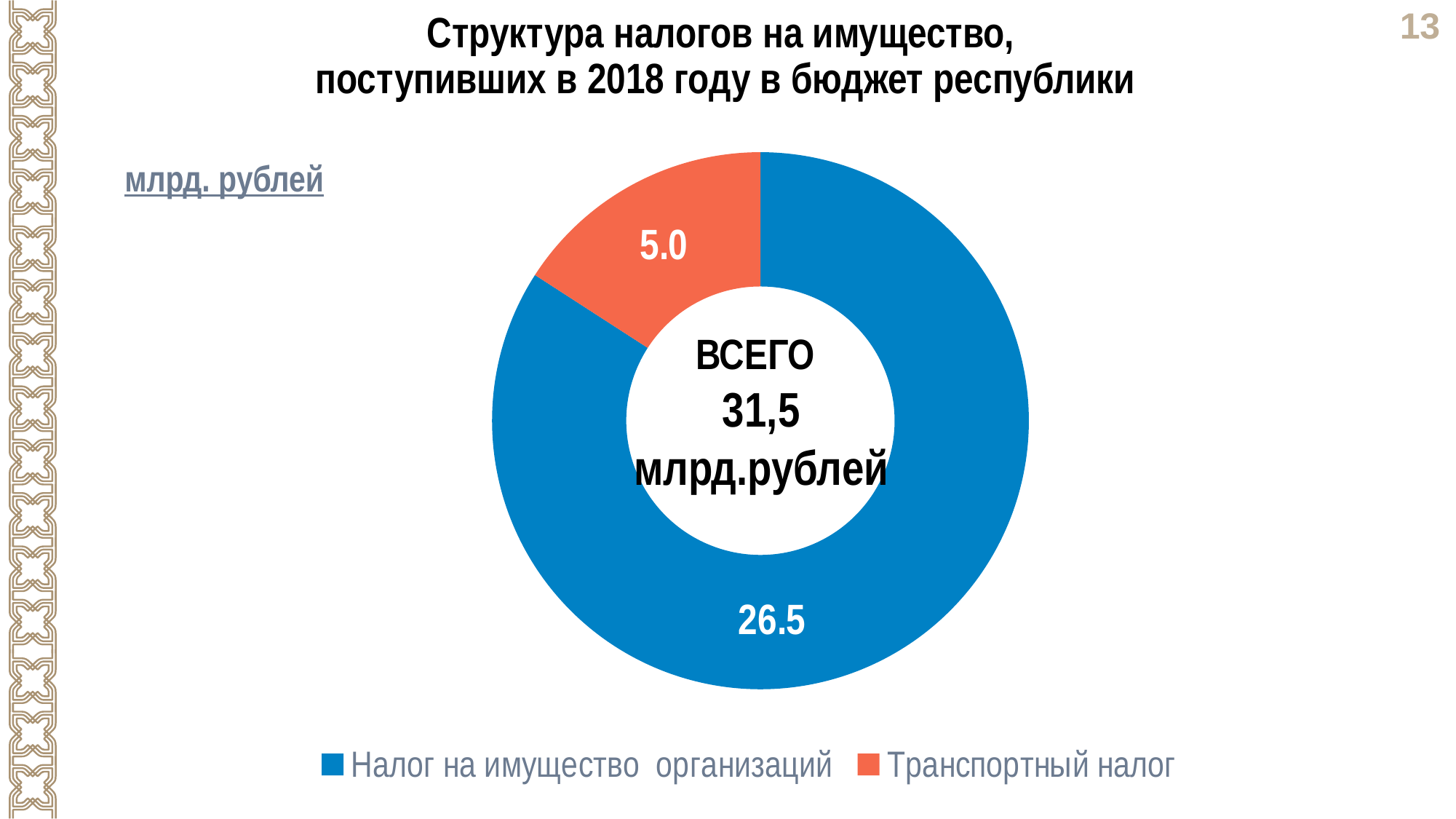
What colour is the slice for Транспортный налог? Orange What kind of chart is shown on the slide? Pie chart (doughnut) What is the title of the chart? Структура налогов на имущество, поступивших в 2018 году в бюджет республики What total is printed in the centre of the chart? 31,5 млрд.рублей How many slices does the chart have? 2 What is the difference between the values for Налог на имущество организаций and Транспортный налог? 21.5 Which is larger: Налог на имущество организаций or Транспортный налог? Налог на имущество организаций Which category has the largest slice? Налог на имущество организаций What is the value for Транспортный налог? 5.0 How many series does the legend list? 2 Which category has the smallest slice? Транспортный налог What is the value for Налог на имущество организаций? 26.5